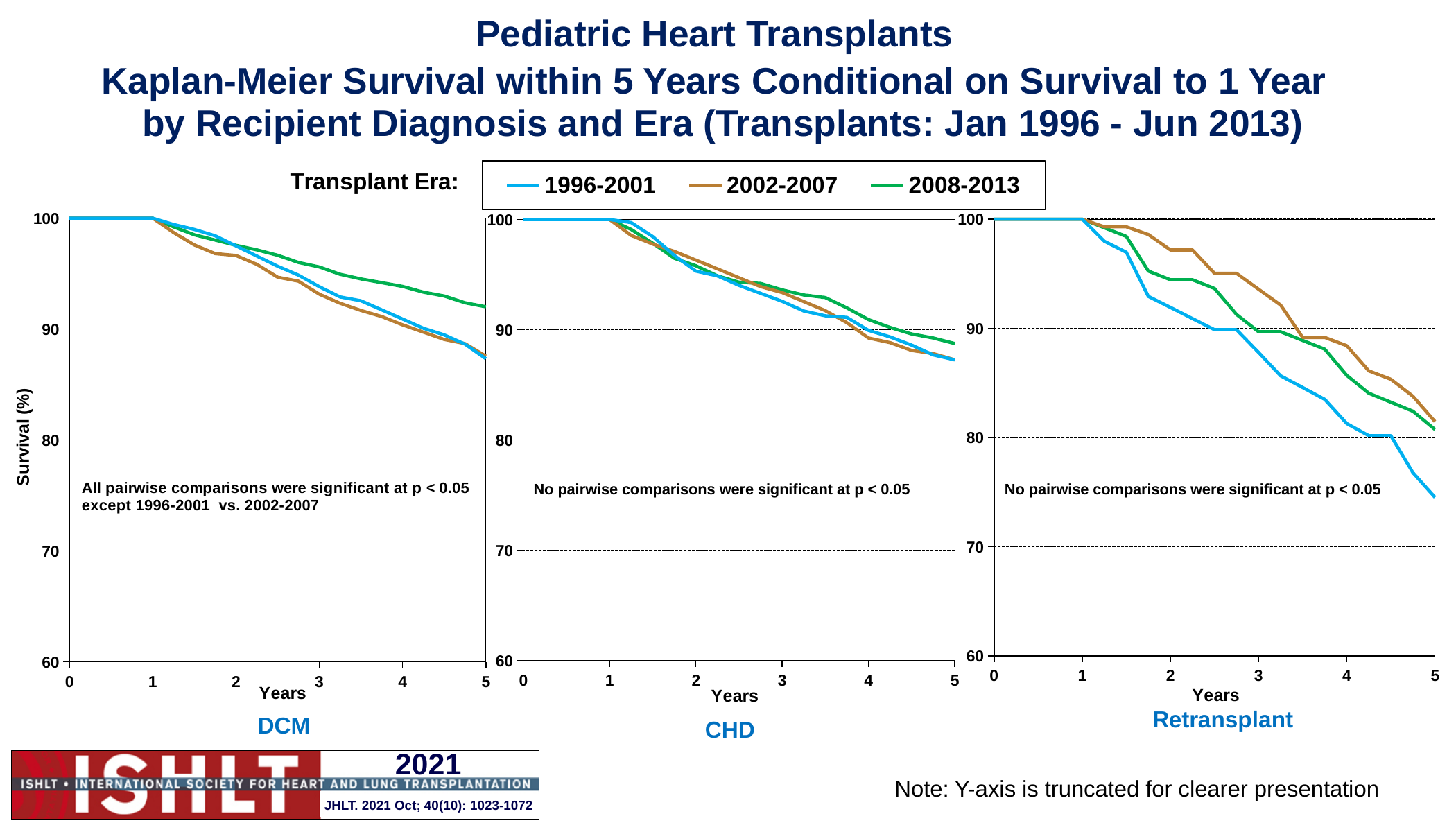
How many diagnosis panels (charts) are shown on the slide? 3 In the Retransplant chart, which transplant era has the lowest survival at 5 years? 1996-2001 What kind of chart is used in the DCM panel? line chart In the CHD chart, is the survival for 1996-2001 at 5 years greater or less than 90? less In the DCM chart, which transplant era has the highest survival at 5 years? 2008-2013 In the DCM chart, is the survival for 2008-2013 at 5 years greater or less than 90? greater In the Retransplant chart, is the survival for 1996-2001 at 5 years greater or less than 80? less In the Retransplant chart, at 2 years, which era has higher survival: 1996-2001 or 2002-2007? 2002-2007 What is the lowest value shown on the Survival (%) axis? 60 How many transplant eras does the legend list? 3 In the DCM chart, do the survival curves rise or fall as years increase? fall Which transplant eras are listed in the legend? 1996-2001, 2002-2007, 2008-2013